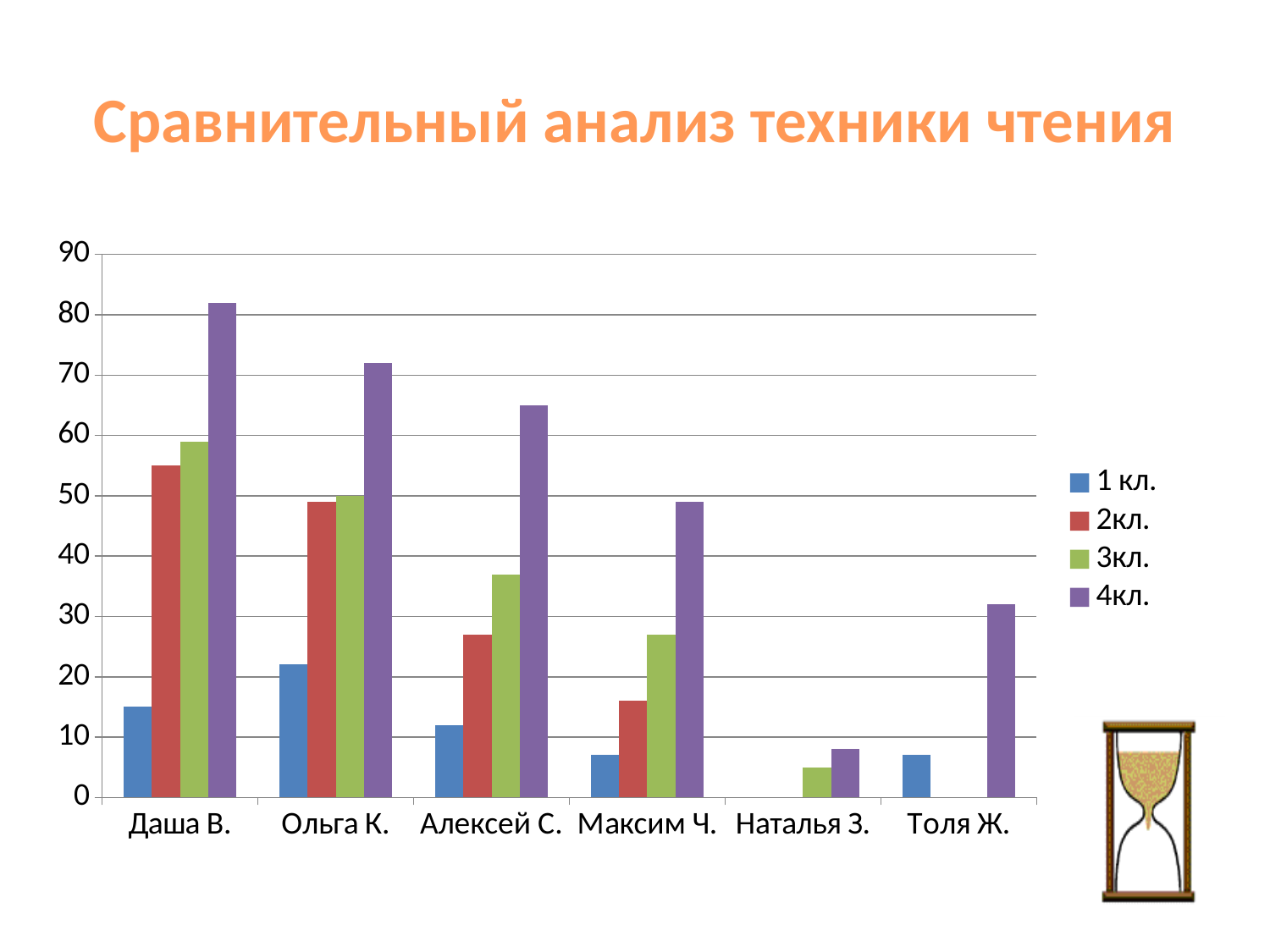
Is the 3кл. value for Алексей С. greater or less than 40? less Which student has the lowest 4кл. value? Наталья З. For Максим Ч., do the values rise or fall from 1 кл. to 4кл.? rise Which student has the highest 4кл. value? Даша В. Is the 4кл. value for Ольга К. greater or less than 70? greater How many series does the legend list? 4 Is the 4кл. value for Даша В. greater or less than 80? greater What is the title of the chart on the slide? Сравнительный анализ техники чтения Which is larger, the 2кл. value for Даша В. or the 2кл. value for Ольга К.? Даша В. What kind of chart is shown on the slide? bar chart How many students (categories) are shown on the x axis? 6